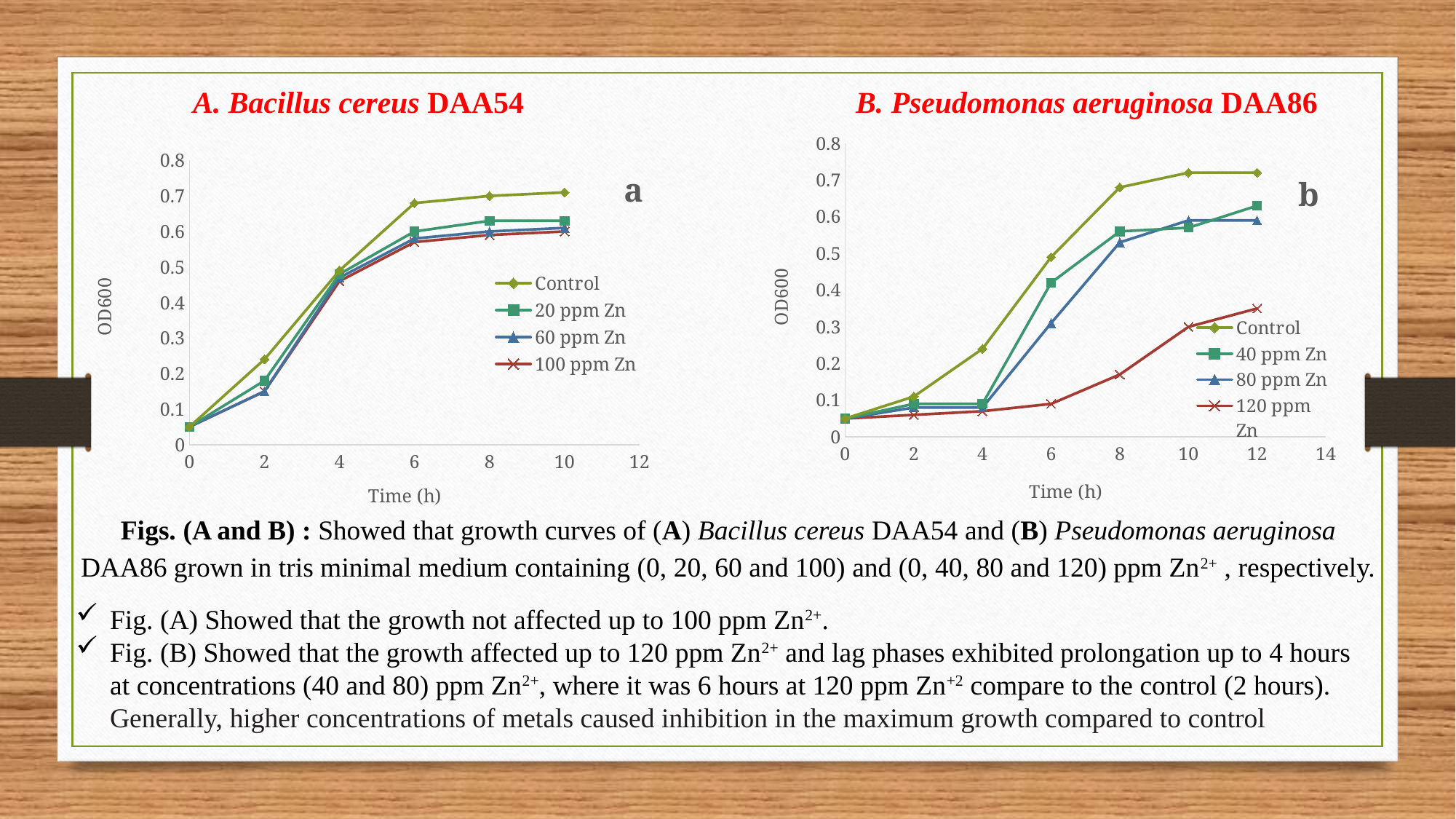
In the chart titled 'B. Pseudomonas aeruginosa DAA86', which series has the lowest OD600 at 12 h? 120 ppm Zn What kind of chart is the chart titled 'A. Bacillus cereus DAA54'? line chart What is the label of the y axis in the chart titled 'A. Bacillus cereus DAA54'? OD600 In the chart titled 'B. Pseudomonas aeruginosa DAA86', is the OD600 for 80 ppm Zn at 6 h greater or less than 0.4? less In the chart titled 'B. Pseudomonas aeruginosa DAA86', at 8 h, which is larger: the OD600 for Control or for 120 ppm Zn? Control In the chart titled 'B. Pseudomonas aeruginosa DAA86', how many time points are plotted for each series? 7 In the chart titled 'A. Bacillus cereus DAA54', is the OD600 for Control at 6 h greater or less than 0.6? greater In the chart titled 'B. Pseudomonas aeruginosa DAA86', is the OD600 for 120 ppm Zn at 12 h greater or less than 0.4? less In the chart titled 'A. Bacillus cereus DAA54', how many time points are plotted for each series? 6 How many series does the legend list in the chart titled 'B. Pseudomonas aeruginosa DAA86'? 4 In the chart titled 'B. Pseudomonas aeruginosa DAA86', which series has the highest OD600 at 12 h? Control In the chart titled 'A. Bacillus cereus DAA54', does the Control series rise or fall from 0 h to 10 h? rise